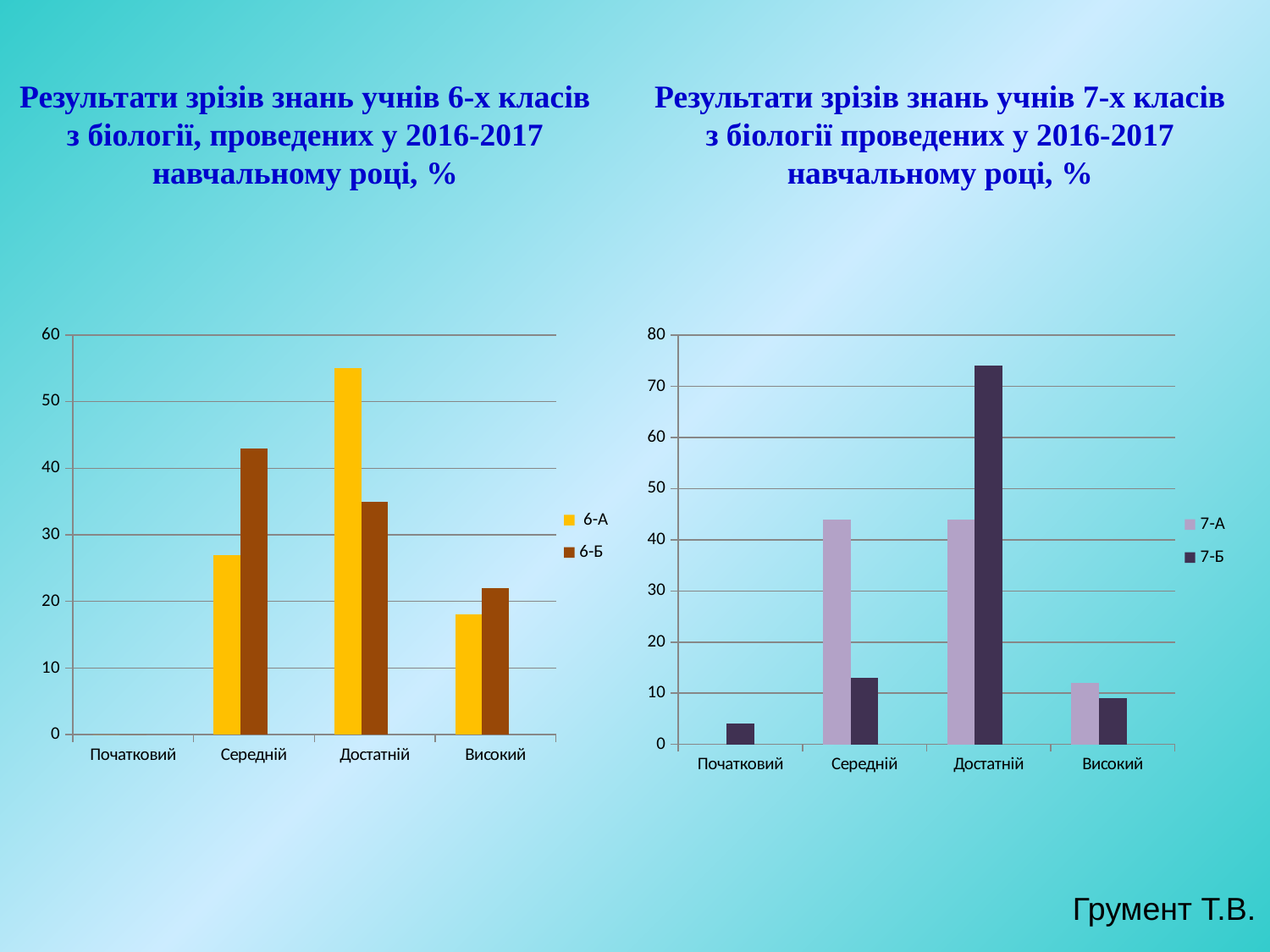
On the left chart (6-х класів), is the value for 6-А in Достатній greater or less than 50? greater On the right chart (7-х класів), which is larger for Середній: 7-А or 7-Б? 7-А On the right chart (7-х класів), is the value for 7-Б in Достатній greater or less than 70? greater On the left chart (6-х класів), what kind of chart is shown? bar chart On the right chart (7-х класів), how many categories are shown on the x axis? 4 On the left chart (6-х класів), which is larger for Високий: 6-А or 6-Б? 6-Б On the right chart (7-х класів), which category has the highest value for 7-Б? Достатній On the right chart (7-х класів), is the value for 7-Б in Початковий greater or less than 10? less On the left chart (6-х класів), which category has the highest value for 6-Б? Середній On the left chart (6-х класів), which is larger for Середній: 6-А or 6-Б? 6-Б On the left chart (6-х класів), which category has the highest value for 6-А? Достатній On the left chart (6-х класів), how many series does the legend list? 2